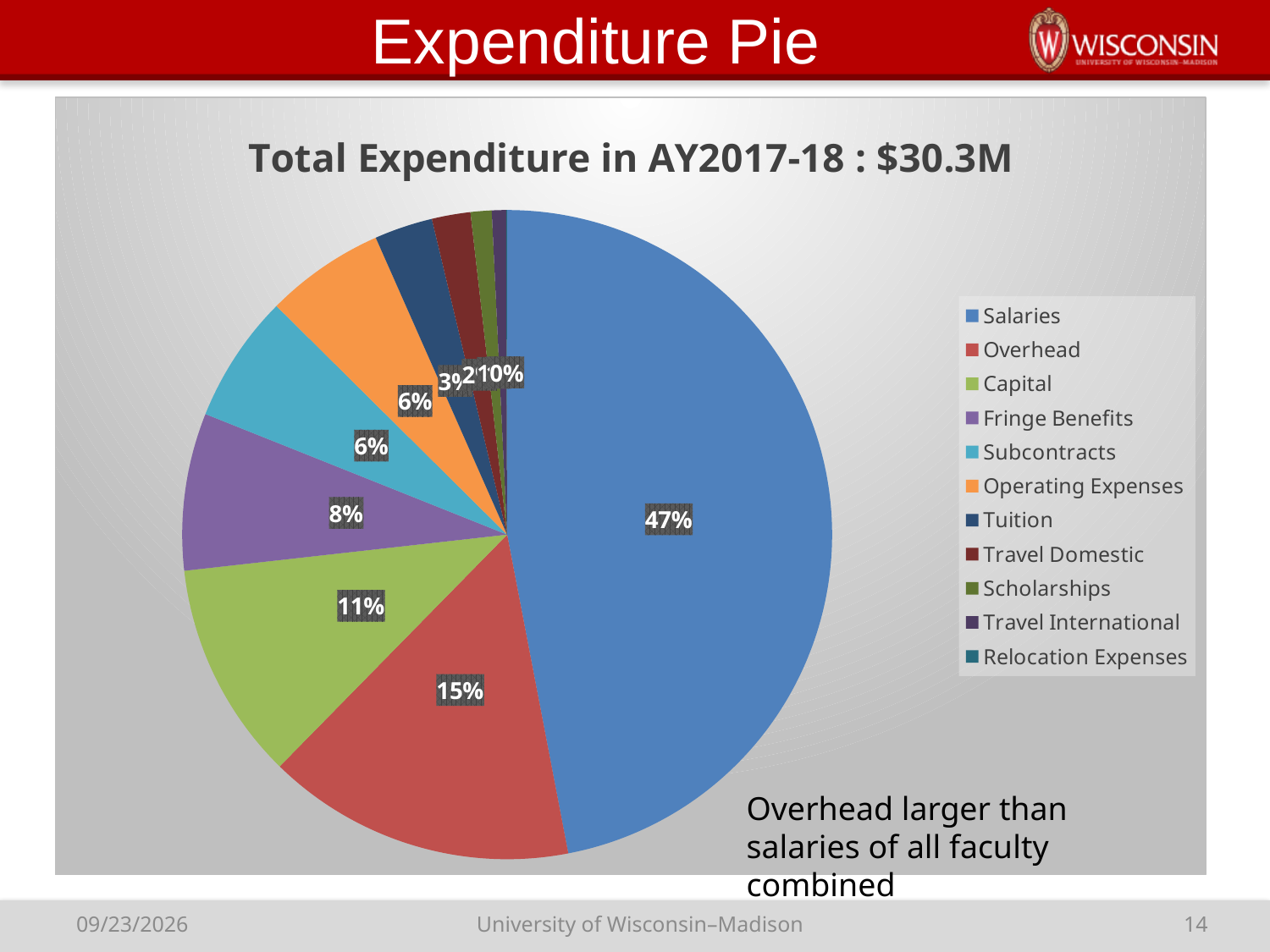
What share of total expenditure is Salaries? 47% How many percentage points larger is the Salaries slice than the Overhead slice? 32% What share of total expenditure is Capital? 11% Which is larger, the Overhead slice or the Capital slice? Overhead What share of total expenditure is Subcontracts? 6% Which category has the largest slice of the pie? Salaries What kind of chart is shown on the slide? pie chart What is the title of the pie chart? Total Expenditure in AY2017-18 : $30.3M How many categories does the legend list? 11 How many percentage points larger is the Capital slice than the Fringe Benefits slice? 3%